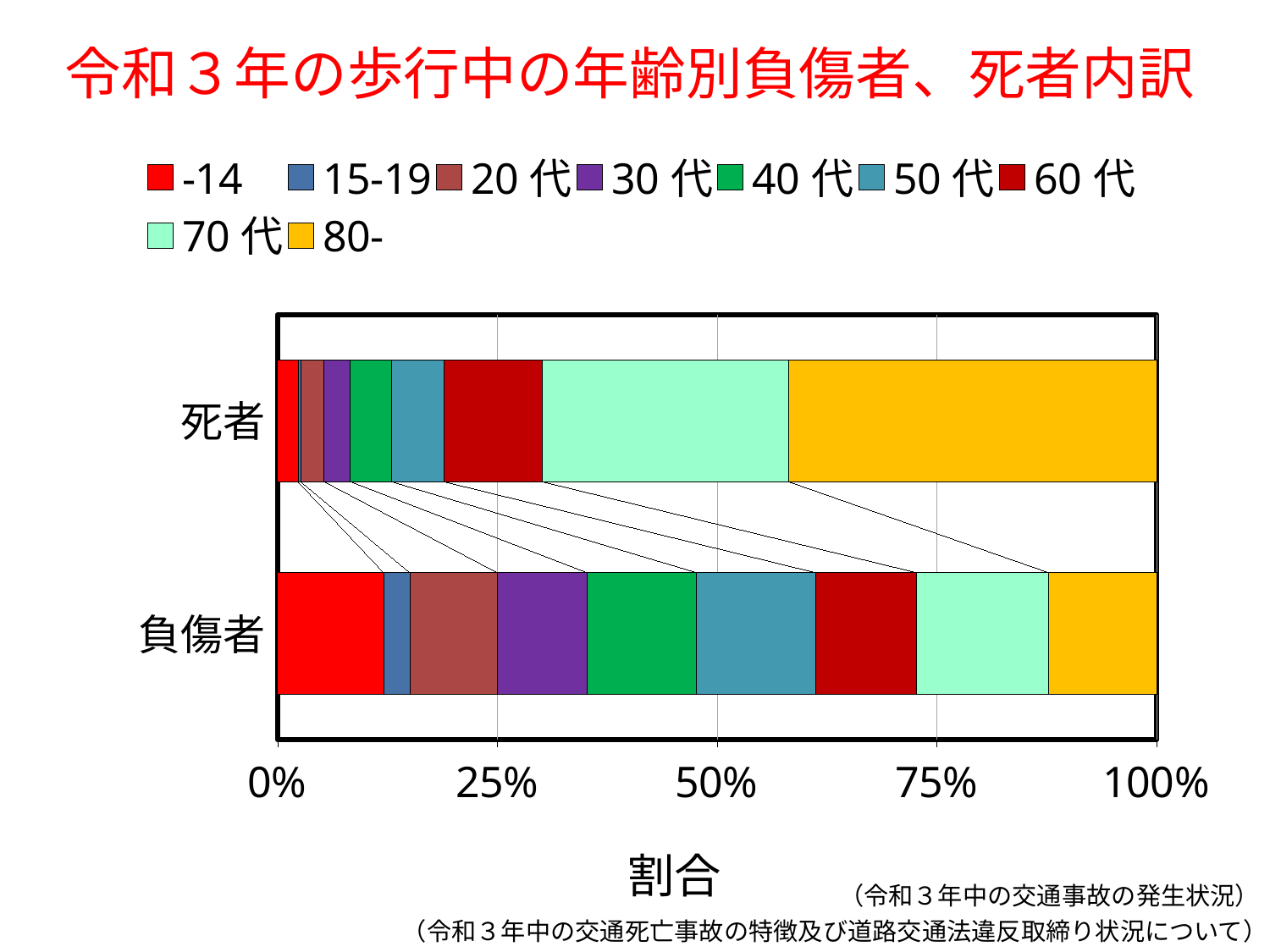
Which bar has the larger share for the -14 group, 死者 or 負傷者? 負傷者 Which age group has the largest share in the 死者 bar? 80- Is the share of the 80- group in the 負傷者 bar greater or less than 25%? less Which bar has the larger share for the 70代 group, 死者 or 負傷者? 死者 How many categories (bars) does the chart show? 2 What is the title of the chart on the slide? 令和３年の歩行中の年齢別負傷者、死者内訳 How many series does the legend list? 9 Is the share of the -14 group in the 負傷者 bar greater or less than 25%? less Which bar has the larger share for the 80- group, 死者 or 負傷者? 死者 Is the share of the 80- group in the 死者 bar greater or less than 25%? greater What kind of chart is shown on the slide? Stacked bar chart What is the label of the horizontal axis? 割合